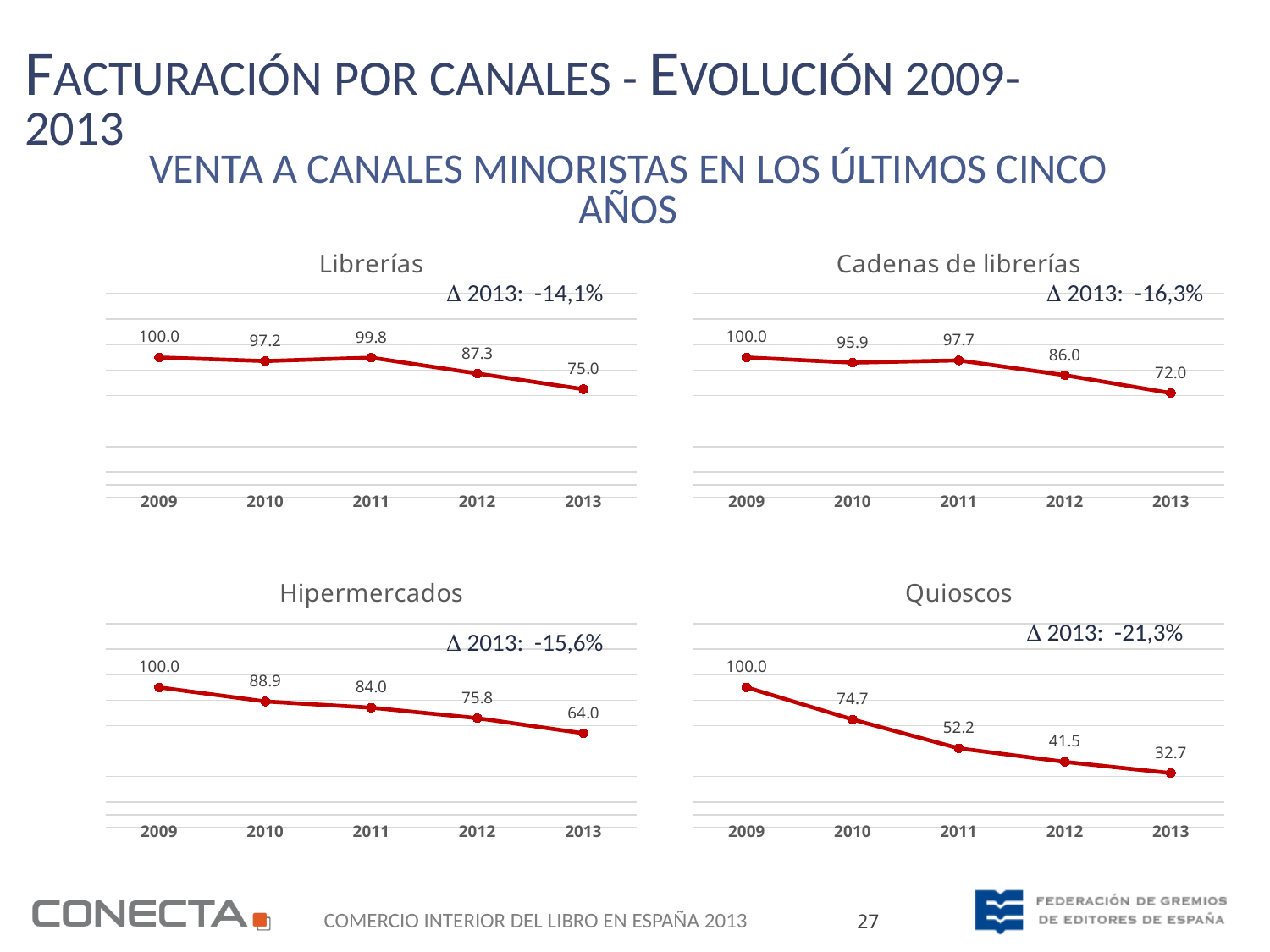
In the Librerías chart, what is the value for 2012? 87.3 In the Hipermercados chart, which year has the highest value? 2009 In the Hipermercados chart, what is the value for 2010? 88.9 In the Quioscos chart, what is the value for 2011? 52.2 In the Quioscos chart, do the values rise or fall from 2009 to 2013? fall In the Cadenas de librerías chart, which is larger, the value for 2010 or the value for 2011? 2011 What kind of chart is the Quioscos chart? line chart In the Quioscos chart, which year has the lowest value? 2013 How many data points are plotted in the Hipermercados chart? 5 In the Cadenas de librerías chart, what is the value for 2013? 72.0 In the Quioscos chart, what is the difference between the 2010 value and the 2011 value? 22.5 In the Librerías chart, what is the difference between the 2009 value and the 2013 value? 25.0